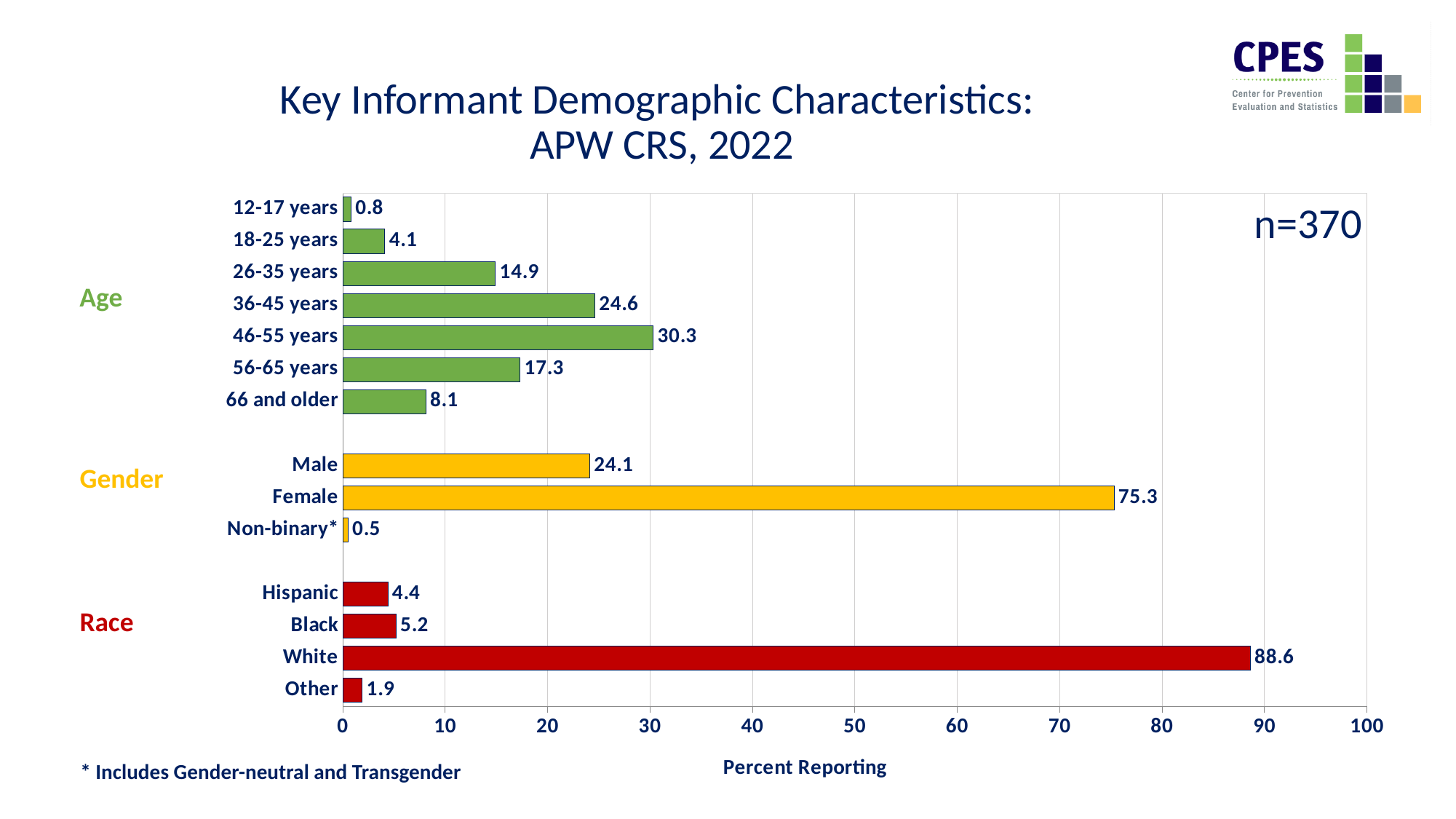
Which is larger, the value for 36-45 years or the value for 56-65 years? 36-45 years What is the label of the horizontal axis? Percent Reporting What kind of chart is shown on the slide? Bar chart Which age group has the lowest value? 12-17 years What percent of key informants reported being Female? 75.3 How many age group categories are shown on the chart? 7 Which age group has the highest value? 46-55 years What is the sample size (n) shown on the chart? n=370 What is the value for the 46-55 years age group? 30.3 What is the difference between the Female and Male values? 51.2 What is the value for the Black race category? 5.2 Is the value for White greater or less than 80? greater